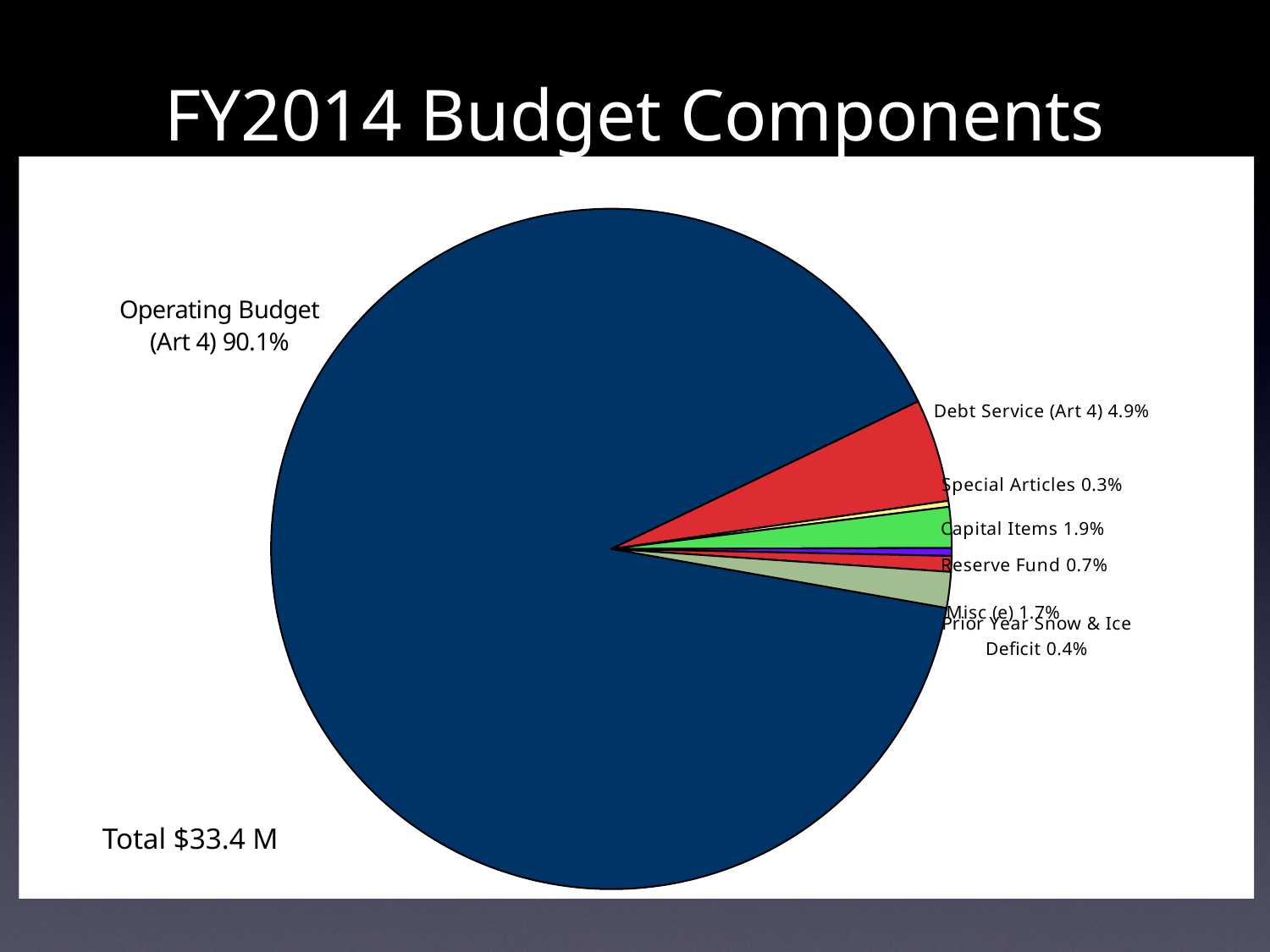
What share of the pie does Debt Service (Art 4) represent? 4.9% Which budget component has the smallest share of the pie? Special Articles How many slices does the pie chart have? 7 What total amount is stated on the slide for the budget? $33.4 M What is the value shown for Prior Year Snow & Ice Deficit? 0.4% Which is larger, Misc (e) or Reserve Fund? Misc (e) Which budget component has the largest share of the pie? Operating Budget (Art 4) What is the value shown for Reserve Fund? 0.7% What is the difference in percentage points between Debt Service (Art 4) and Capital Items? 3.0 What kind of chart is shown on the slide? pie chart What share of the pie does Operating Budget (Art 4) represent? 90.1% What is the value shown for Capital Items? 1.9%